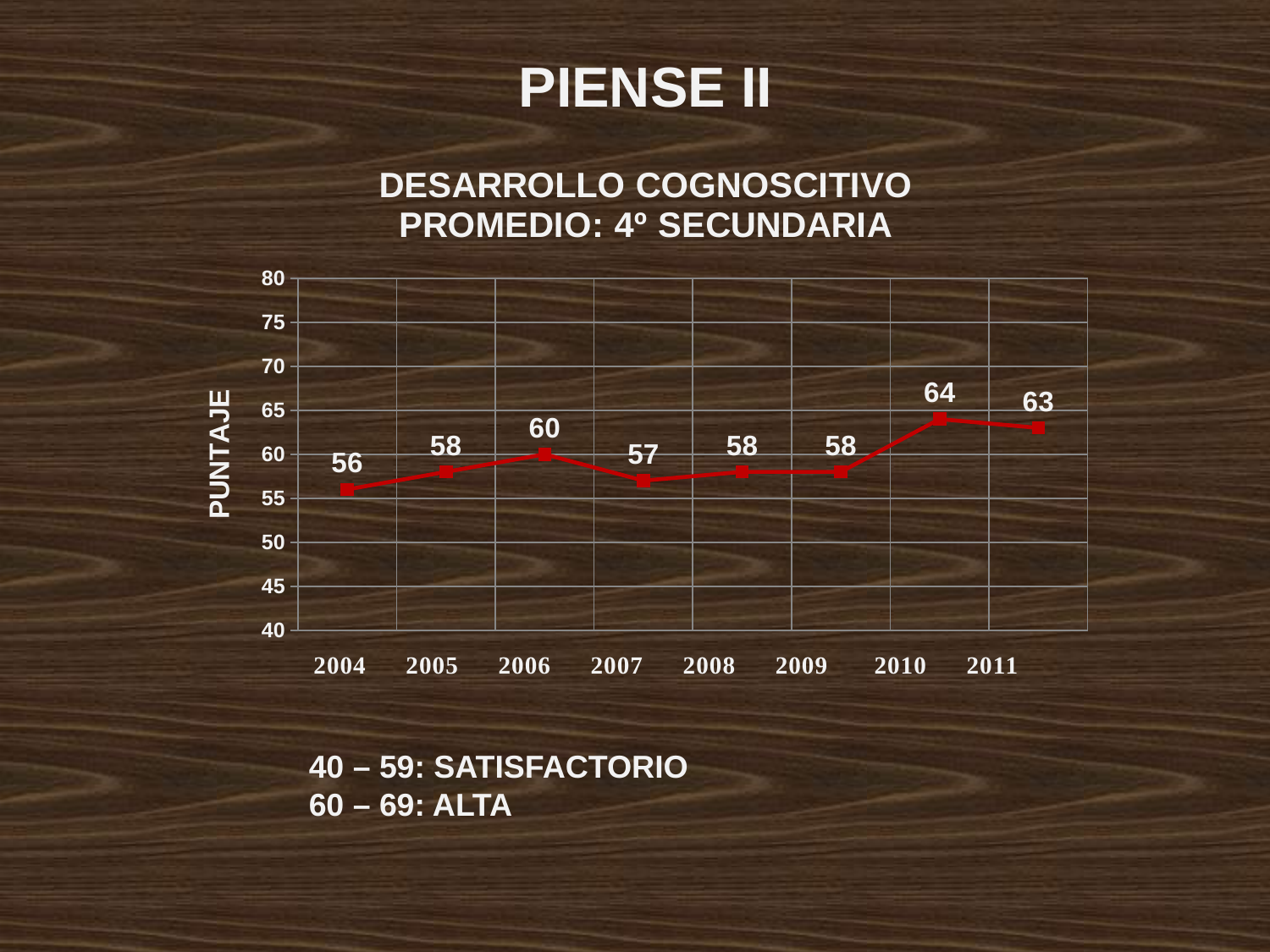
What kind of chart is shown on the slide? line chart What is the PUNTAJE value for 2010? 64 What is the PUNTAJE value for 2007? 57 Is the PUNTAJE value for 2011 greater or less than 60? greater Which is larger, the PUNTAJE value for 2006 or for 2007? 2006 How many years are plotted on the chart? 8 What is the label on the vertical axis of the chart? PUNTAJE What is the difference between the PUNTAJE values for 2010 and 2004? 8 Does the PUNTAJE value rise or fall from 2009 to 2010? rise Which year has the highest PUNTAJE value? 2010 Which year has the lowest PUNTAJE value? 2004 What is the PUNTAJE value for 2004? 56